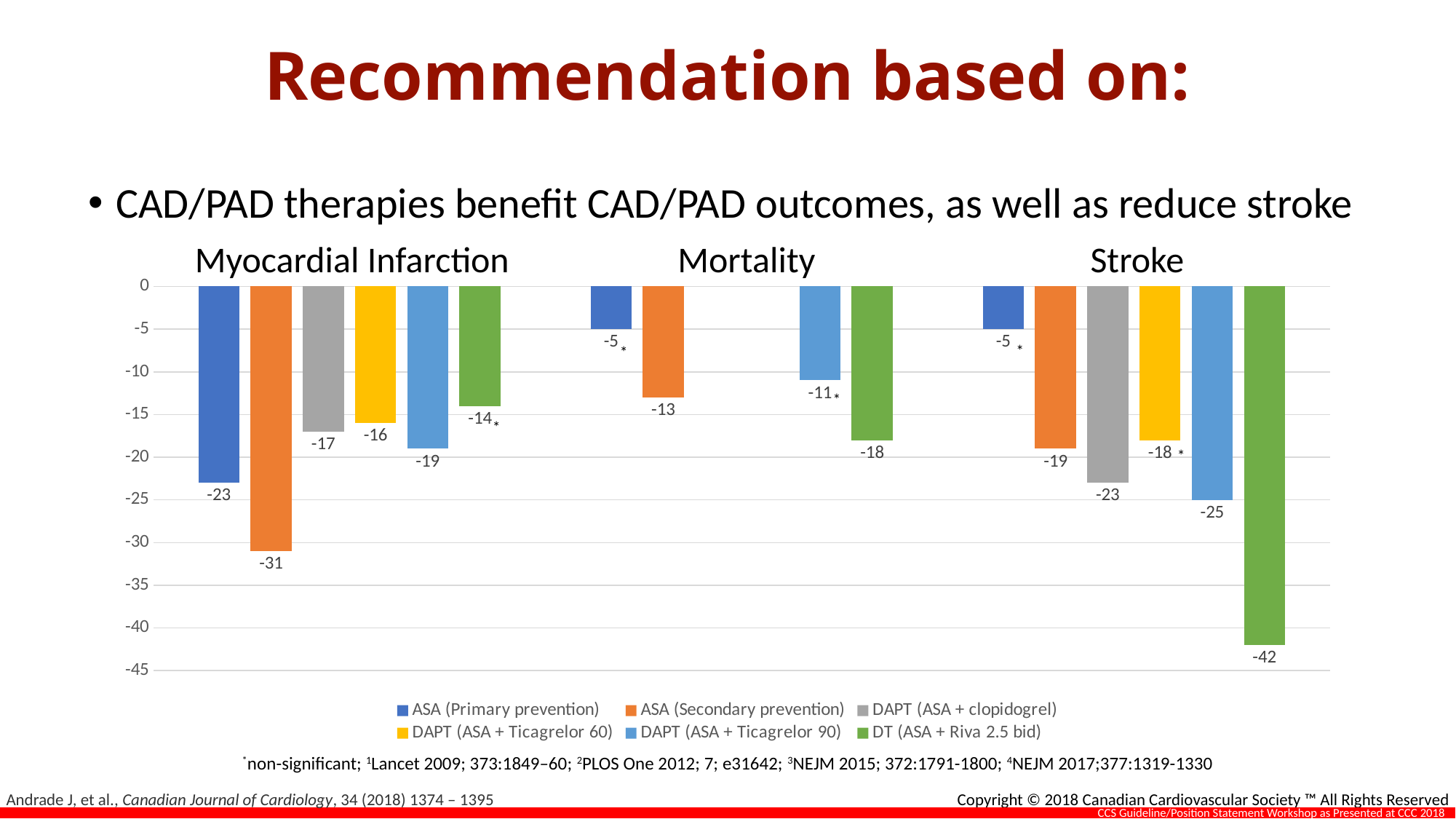
What is the value for DT (ASA + Riva 2.5 bid) in the Stroke group? -42 Which series has the value closest to zero in the Mortality group? ASA (Primary prevention) How many series does the legend list? 6 What is the value for DAPT (ASA + Ticagrelor 90) in the Mortality group? -11 What colour are the DT (ASA + Riva 2.5 bid) bars? Green What kind of chart is shown on the slide? Bar chart How many outcome groups are shown on the x axis? 3 What is the difference between the ASA (Secondary prevention) value and the ASA (Primary prevention) value in the Myocardial Infarction group? 8 What is the value for DAPT (ASA + clopidogrel) in the Stroke group? -23 What is the value for ASA (Secondary prevention) in the Myocardial Infarction group? -31 Which series has the lowest (most negative) value in the Stroke group? DT (ASA + Riva 2.5 bid) Which is more negative: DAPT (ASA + Ticagrelor 90) for Stroke or DAPT (ASA + Ticagrelor 90) for Myocardial Infarction? Stroke